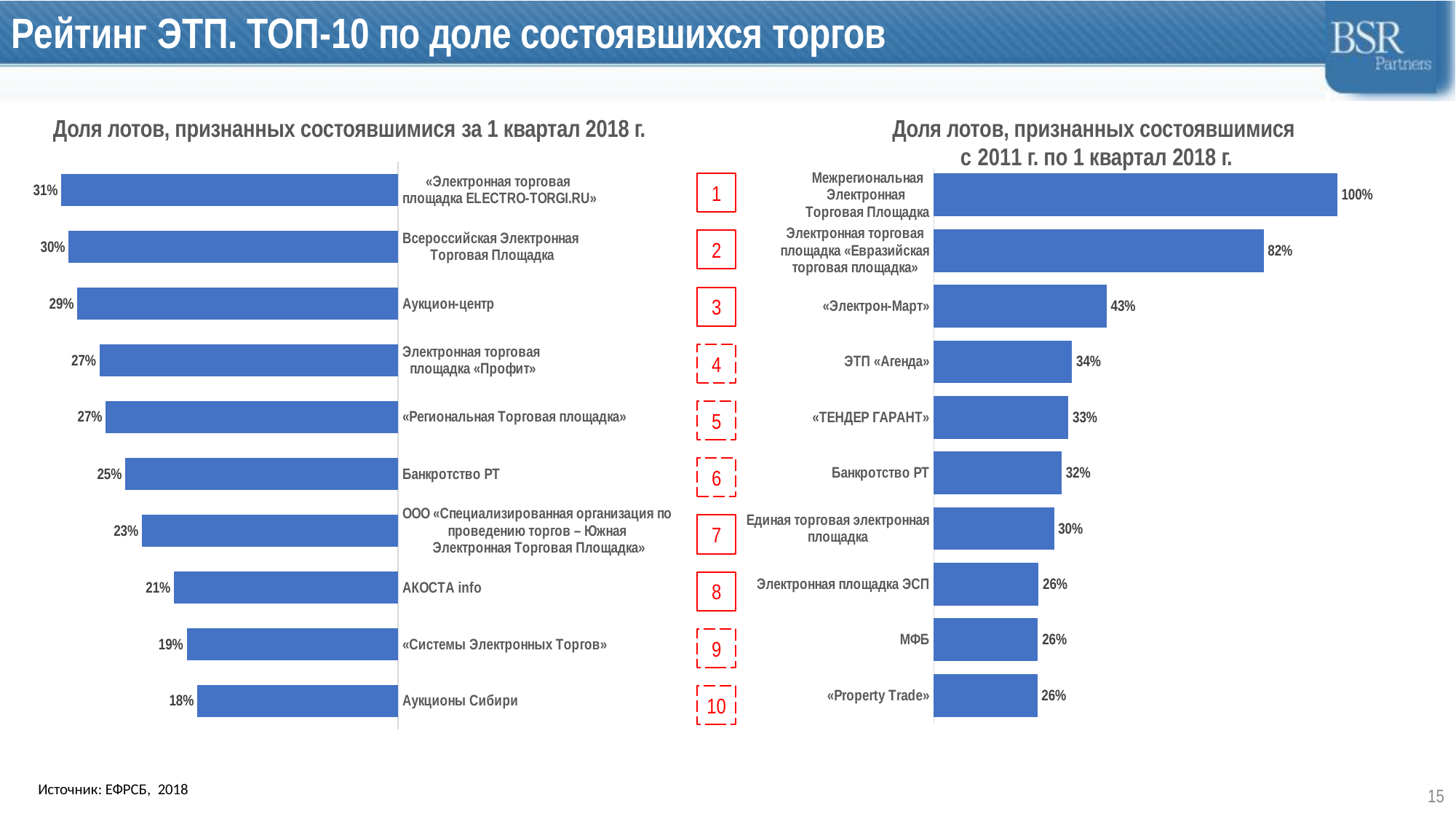
In the left chart (Доля лотов, признанных состоявшимися за 1 квартал 2018 г.), what is the value for Аукцион-центр? 29% In the right chart (с 2011 г. по 1 квартал 2018 г.), what is the value for «Электрон-Март»? 43% In the right chart (с 2011 г. по 1 квартал 2018 г.), which is larger: the value for ЭТП «Агенда» or the value for Единая торговая электронная площадка? ЭТП «Агенда» In the right chart (с 2011 г. по 1 квартал 2018 г.), which platform has the highest share? Межрегиональная Электронная Торговая Площадка In the right chart (с 2011 г. по 1 квартал 2018 г.), what is the value for Банкротство РТ? 32% In the right chart (с 2011 г. по 1 квартал 2018 г.), what is the difference between the values for Межрегиональная Электронная Торговая Площадка and Электронная торговая площадка «Евразийская торговая площадка»? 18% How many platforms are shown in the left chart (1 квартал 2018 г.)? 10 In the left chart (1 квартал 2018 г.), which platform has the lowest share? Аукционы Сибири In the left chart (1 квартал 2018 г.), what is the difference between the values for Всероссийская Электронная Торговая Площадка and Банкротство РТ? 5% In the left chart (1 квартал 2018 г.), what is the value for АКОСТА info? 21% In the left chart (1 квартал 2018 г.), which platform has the highest share? «Электронная торговая площадка ELECTRO-TORGI.RU» What type of chart is used on this slide? Bar chart